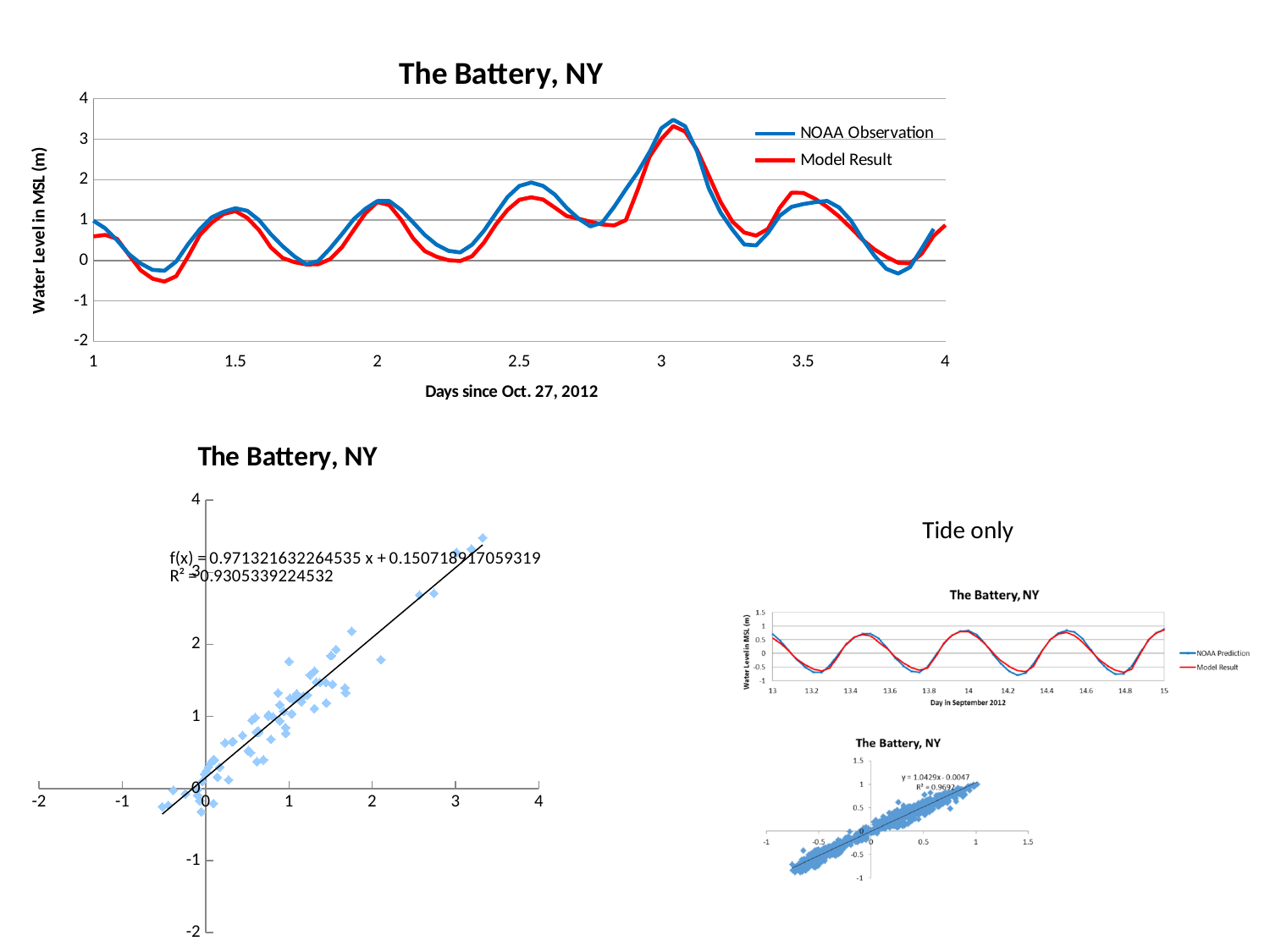
In the top line chart 'The Battery, NY', is the peak value of NOAA Observation near day 3 greater or less than 3? greater In the bottom-left scatter chart 'The Battery, NY', what is the R² value shown? 0.9305339224532 In the top line chart 'The Battery, NY', what are the two legend entries? NOAA Observation, Model Result In the top line chart 'The Battery, NY', is the Model Result value near day 1.25 greater or less than 0? less In the top line chart 'The Battery, NY', how many tick labels are shown on the x axis? 7 What kind of chart is the bottom-left chart titled 'The Battery, NY'? scatter chart In the bottom-left scatter chart 'The Battery, NY', what is the trendline equation shown? f(x) = 0.971321632264535 x + 0.150718917059319 What kind of chart is the top chart titled 'The Battery, NY' with the x axis 'Days since Oct. 27, 2012'? line chart In the top line chart 'The Battery, NY', at around day 2.5, which series is higher: NOAA Observation or Model Result? NOAA Observation In the top line chart 'The Battery, NY', what is the x-axis title? Days since Oct. 27, 2012 In the top line chart 'The Battery, NY', how many series does the legend list? 2